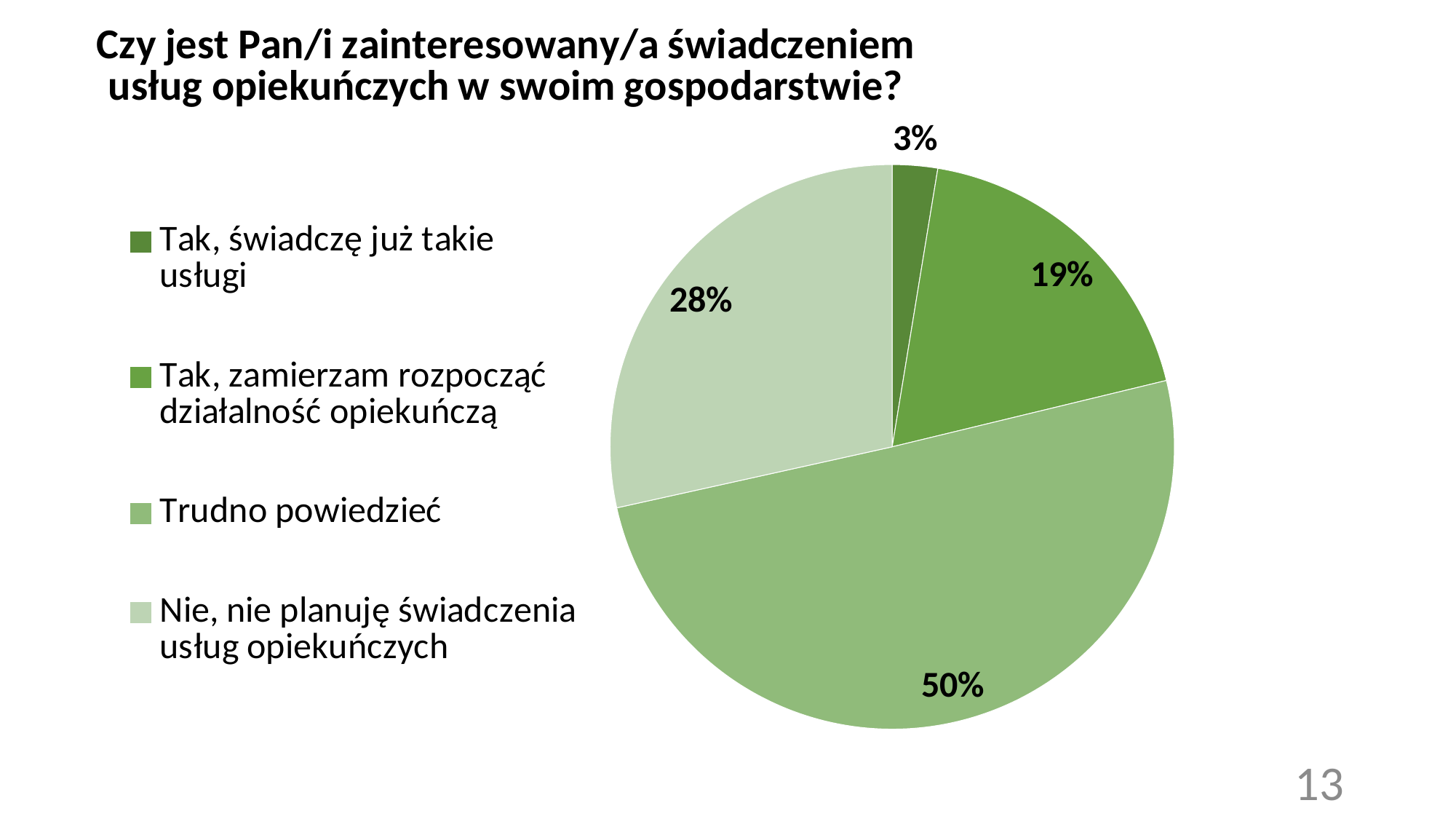
What share of the pie is labelled for "Tak, zamierzam rozpocząć działalność opiekuńczą"? 19% What share of the pie is labelled for "Nie, nie planuję świadczenia usług opiekuńczych"? 28% What type of chart is shown on the slide? pie chart How many entries does the legend list? 4 Which category has the smallest slice of the pie? Tak, świadczę już takie usługi What is the difference in percentage points between "Nie, nie planuję świadczenia usług opiekuńczych" and "Tak, zamierzam rozpocząć działalność opiekuńczą"? 9 What is the title of the chart? Czy jest Pan/i zainteresowany/a świadczeniem usług opiekuńczych w swoim gospodarstwie? What share of the pie is labelled for "Trudno powiedzieć"? 50% Which is larger: the slice for "Nie, nie planuję świadczenia usług opiekuńczych" or the slice for "Tak, zamierzam rozpocząć działalność opiekuńczą"? Nie, nie planuję świadczenia usług opiekuńczych How many slices does the pie chart have? 4 Which category has the largest slice of the pie? Trudno powiedzieć